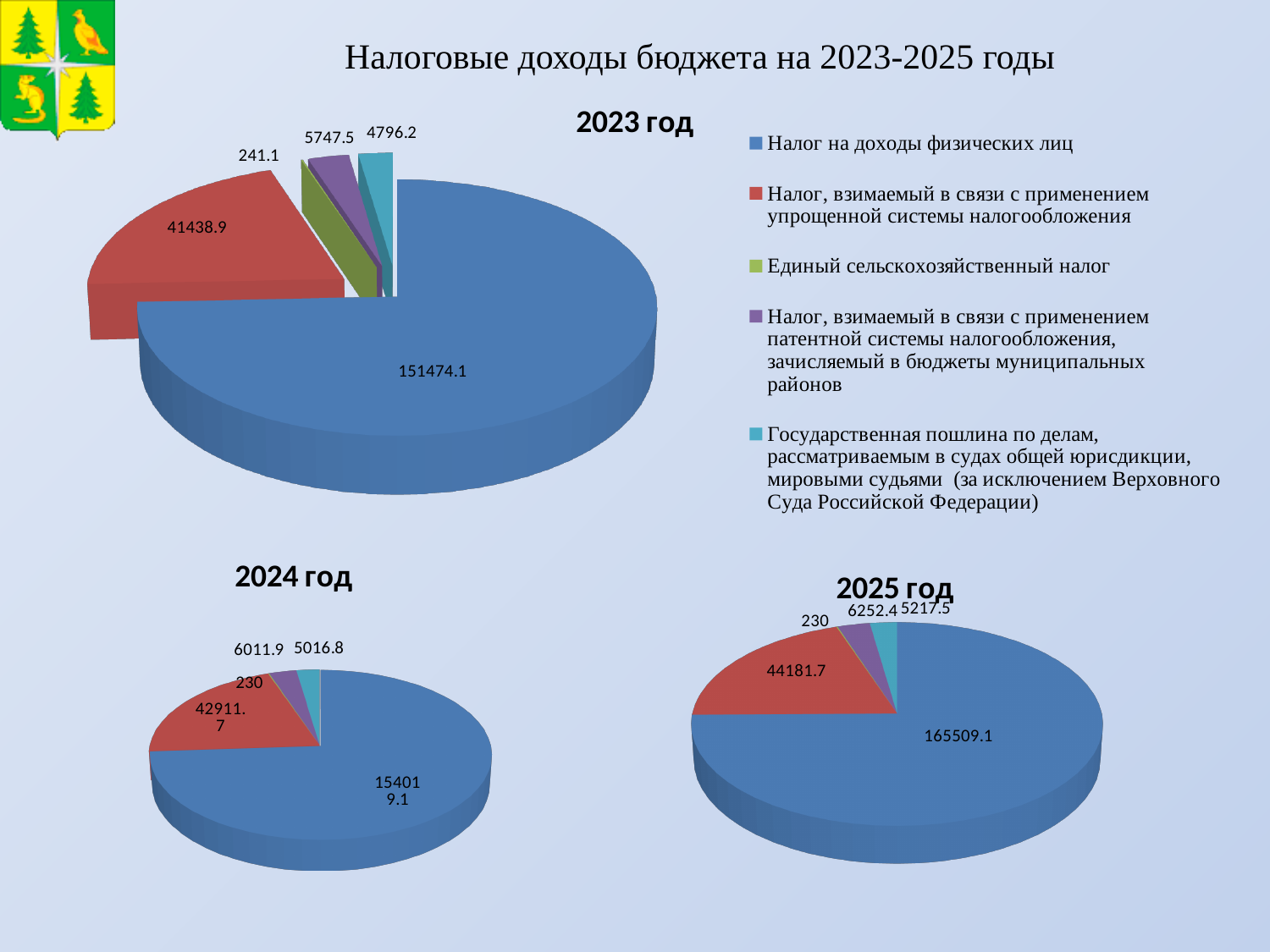
On the 2023 год pie chart, which is larger: the value for Налог, взимаемый в связи с применением патентной системы налогообложения or the value for Государственная пошлина? Налог, взимаемый в связи с применением патентной системы налогообложения How many entries does the legend list? 5 On the 2025 год pie chart, what is the value for Государственная пошлина по делам, рассматриваемым в судах общей юрисдикции? 5217.5 On the 2023 год pie chart, what is the value for Единый сельскохозяйственный налог? 241.1 How many slices does the 2025 год pie chart have? 5 On the 2025 год pie chart, which category has the largest value? Налог на доходы физических лиц On the 2023 год pie chart, what is the value for Налог на доходы физических лиц? 151474.1 On the 2024 год pie chart, what is the value for Налог, взимаемый в связи с применением упрощенной системы налогообложения? 42911.7 What is the difference between the value for Налог, взимаемый в связи с применением патентной системы налогообложения on the 2025 год chart and on the 2024 год chart? 240.5 What type of chart is used for 2024 год? Pie chart On the 2024 год pie chart, which category has the smallest value? Единый сельскохозяйственный налог On the 2023 год pie chart, what is the difference between the value for Налог на доходы физических лиц and the value for Налог, взимаемый в связи с применением упрощенной системы налогообложения? 110035.2